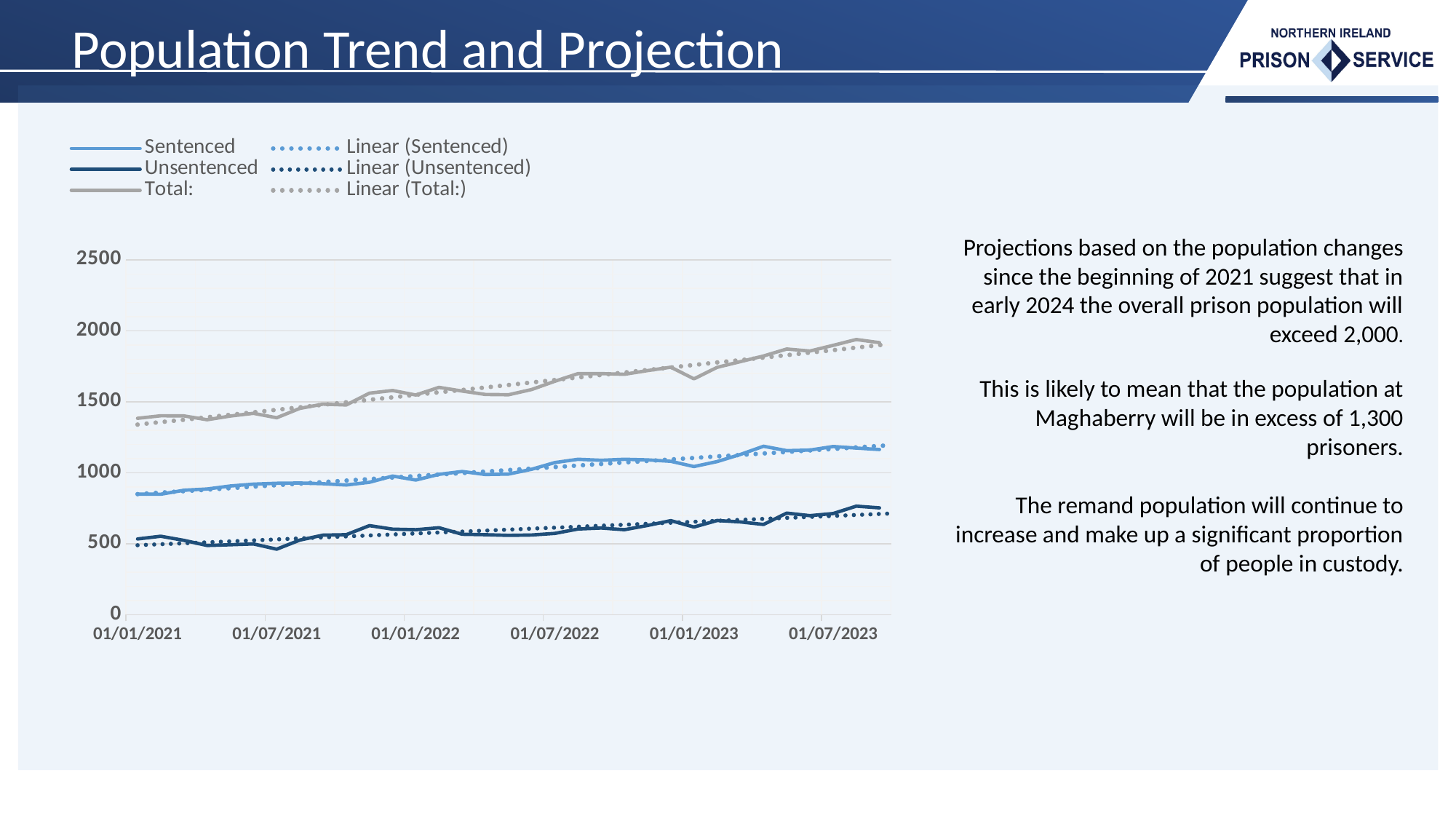
Which is larger at 01/07/2022, the Sentenced value or the Unsentenced value? Sentenced Does the Unsentenced series generally rise or fall across the period shown? Rise Is the value for Sentenced at 01/07/2023 greater or less than 1000? greater Does the Total series rise or fall from 01/01/2021 to 01/07/2023? Rise Is the value for Unsentenced at 01/07/2023 greater or less than 1000? less What kind of chart is shown on the slide? Line chart Is the value for Total at 01/01/2021 greater or less than 1500? less How many entries does the chart legend list? 6 Which series has the lowest values throughout the chart? Unsentenced Which series has the highest values throughout the chart? Total: What is the title of the slide containing the chart? Population Trend and Projection